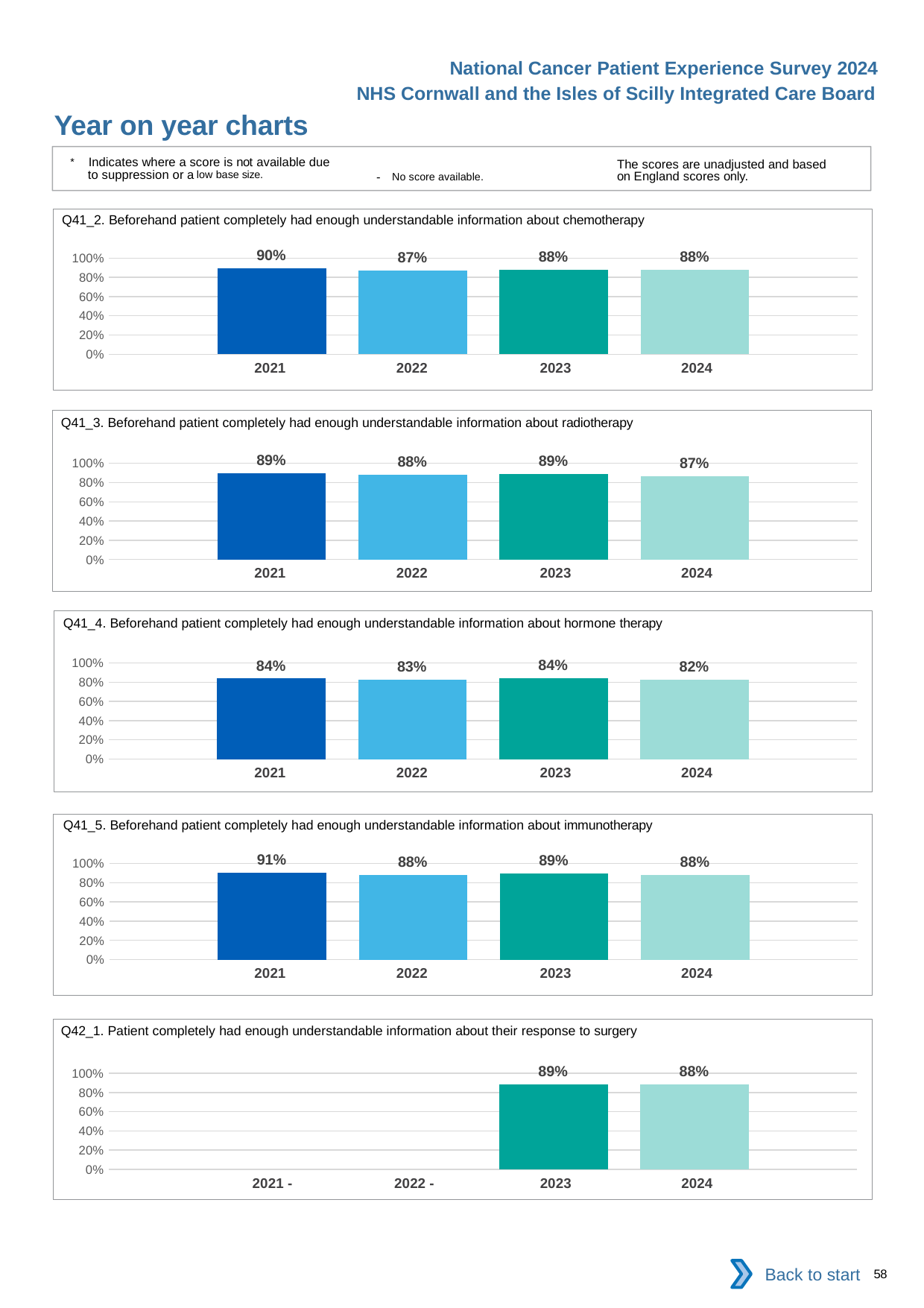
In the Q41_3 chart (radiotherapy), what is the difference between the 2021 and 2024 values? 2 percentage points In the Q41_2 chart (chemotherapy), what is the value for 2021? 90% In the Q41_4 chart (hormone therapy), which year has the lowest value? 2024 In the Q41_3 chart (radiotherapy), what is the value for 2024? 87% In the Q41_2 chart (chemotherapy), which year has the highest value? 2021 What kind of chart is used for Q41_2 (chemotherapy)? Bar chart In the Q41_5 chart (immunotherapy), is the value for 2021 larger than the value for 2022? Yes, 2021 (91%) is larger than 2022 (88%) In the Q42_1 chart (response to surgery), how many years have a plotted bar? 2 In the Q41_4 chart (hormone therapy), what is the value for 2022? 83% In the Q41_5 chart (immunotherapy), what is the value for 2021? 91% In the Q42_1 chart (response to surgery), what is the value for 2023? 89% In the Q41_4 chart (hormone therapy), is the value for 2024 greater or less than 80%? greater